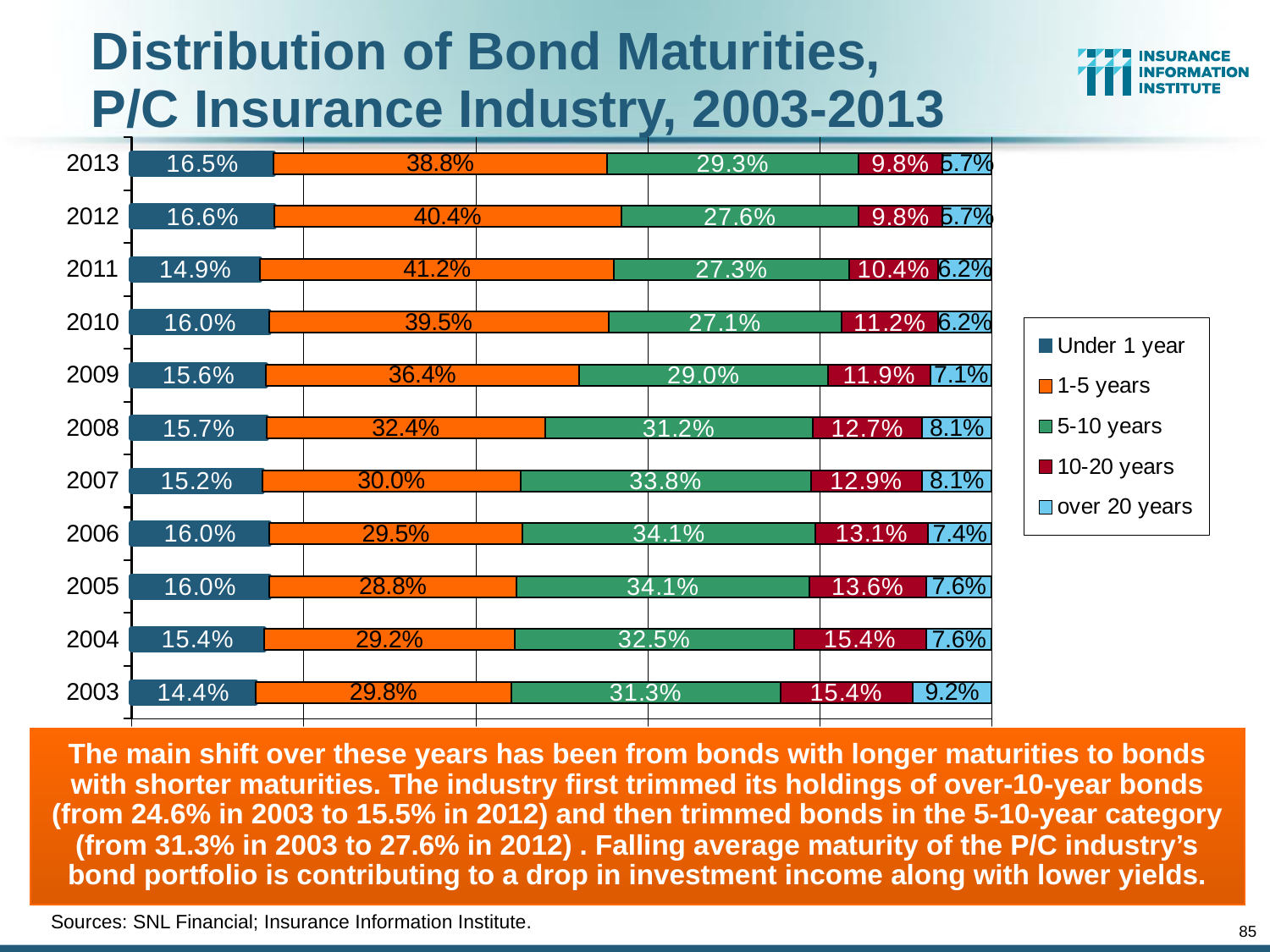
What share of bonds had maturities of over 20 years in 2003? 9.2% What kind of chart is shown on the slide? Stacked bar chart Which year had a larger share of 5-10 year bonds, 2006 or 2013? 2006 How many years are shown on the chart? 11 Which maturity category is shown in orange in the legend? 1-5 years Which year had the lowest share of bonds in the Under 1 year category? 2003 By how many percentage points did the 10-20 years share fall from 2003 to 2013? 5.6 percentage points What share of bonds had maturities of 1-5 years in 2011? 41.2% How many series does the legend list? 5 Did the share of bonds with maturities over 20 years rise or fall from 2003 to 2013? Fall Which year had the highest share of bonds in the 1-5 years category? 2011 What share of bonds had maturities of 5-10 years in 2003? 31.3%